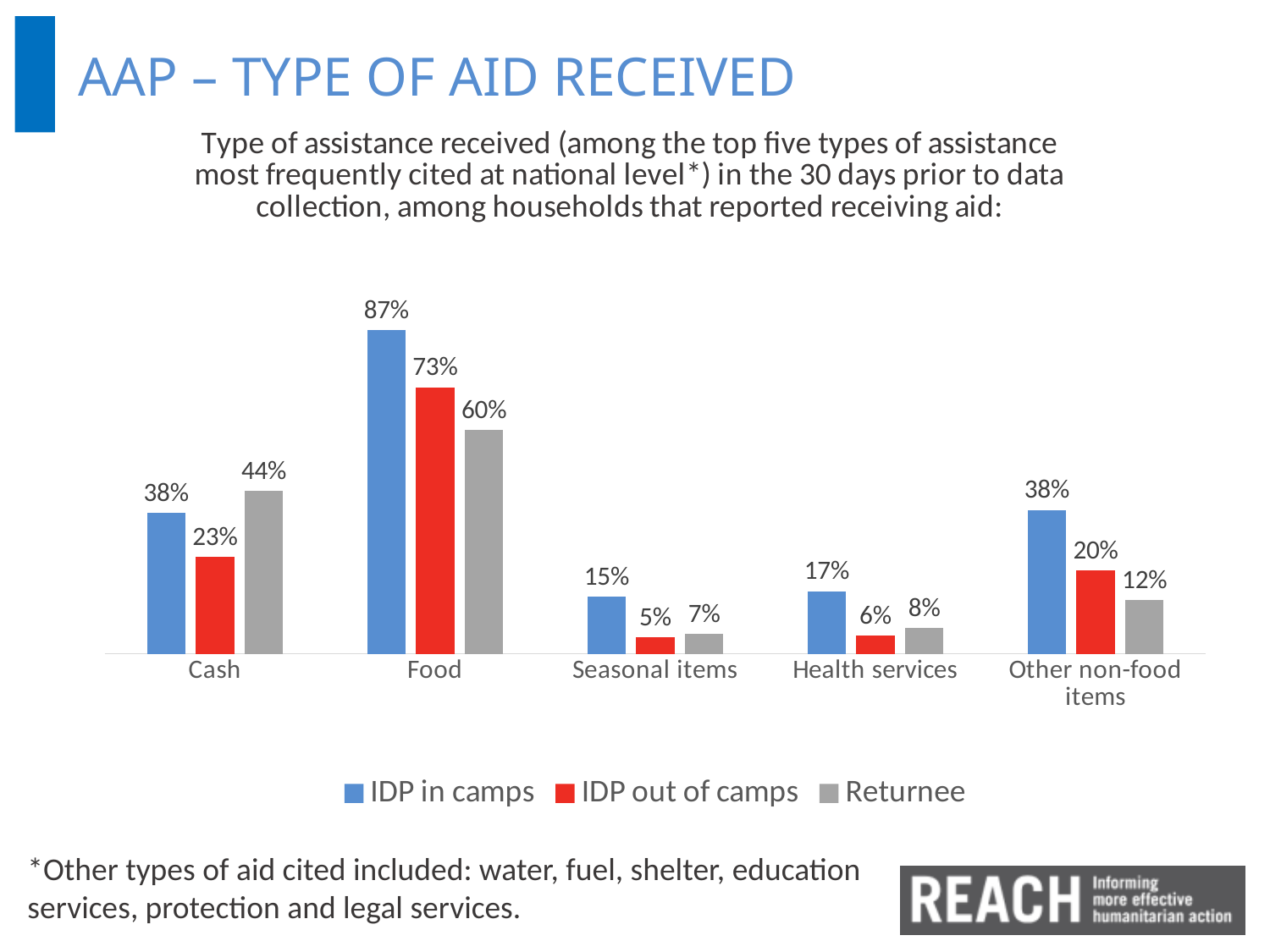
What percentage of IDP out of camps households received seasonal items? 5% What kind of chart is shown on the slide? Bar chart How many series does the legend list? 3 Which type of aid has the highest value for IDP in camps? Food Which type of aid has the lowest value for Returnee households? Seasonal items What is the difference between Returnee and IDP out of camps for Cash? 21% What is the value for Returnee households under Cash? 44% What is the difference between IDP in camps and Returnee for Food? 27% For Cash, which group has the larger value: IDP out of camps or Returnee? Returnee For Other non-food items, which group has the larger value: IDP in camps or Returnee? IDP in camps How many types of aid are shown on the x axis? 5 What percentage of IDP in camps households received food aid? 87%